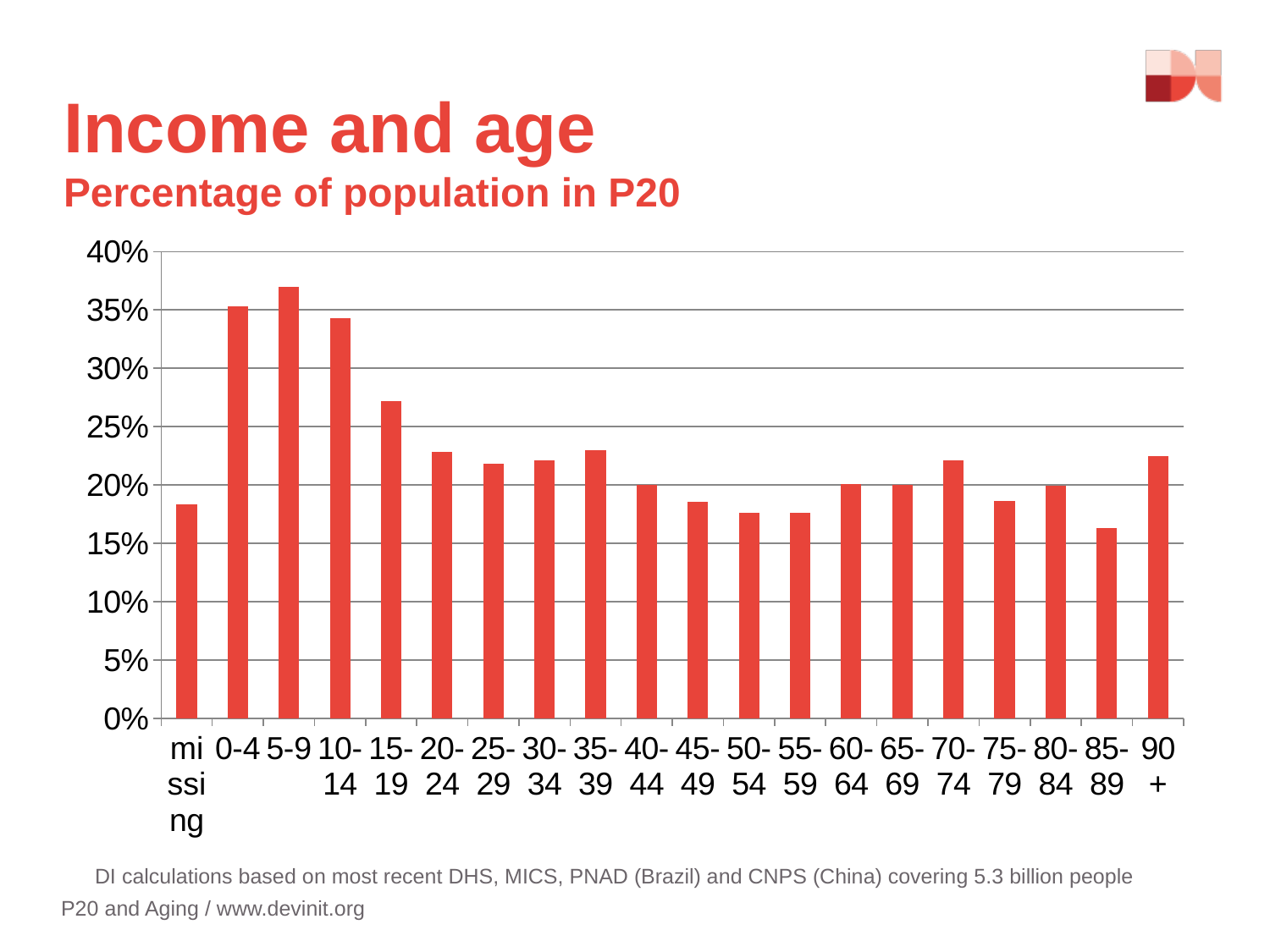
Which has a higher percentage of population in P20: the 0-4 age group or the 15-19 age group? 0-4 Which age group has the lowest percentage of population in P20? 85-89 How many categories are shown on the x axis of the chart? 20 Is the value for the 5-9 age group greater or less than 35%? greater Do the values rise or fall from the 5-9 age group to the 50-54 age group? Fall Which age group has the highest percentage of population in P20? 5-9 Is the value for the 'missing' category greater or less than 20%? less Is the value for the 85-89 age group greater or less than 20%? less Which has a higher percentage of population in P20: the 90+ age group or the 85-89 age group? 90+ What kind of chart is shown on the slide? Bar chart What is the subtitle describing what the chart measures? Percentage of population in P20